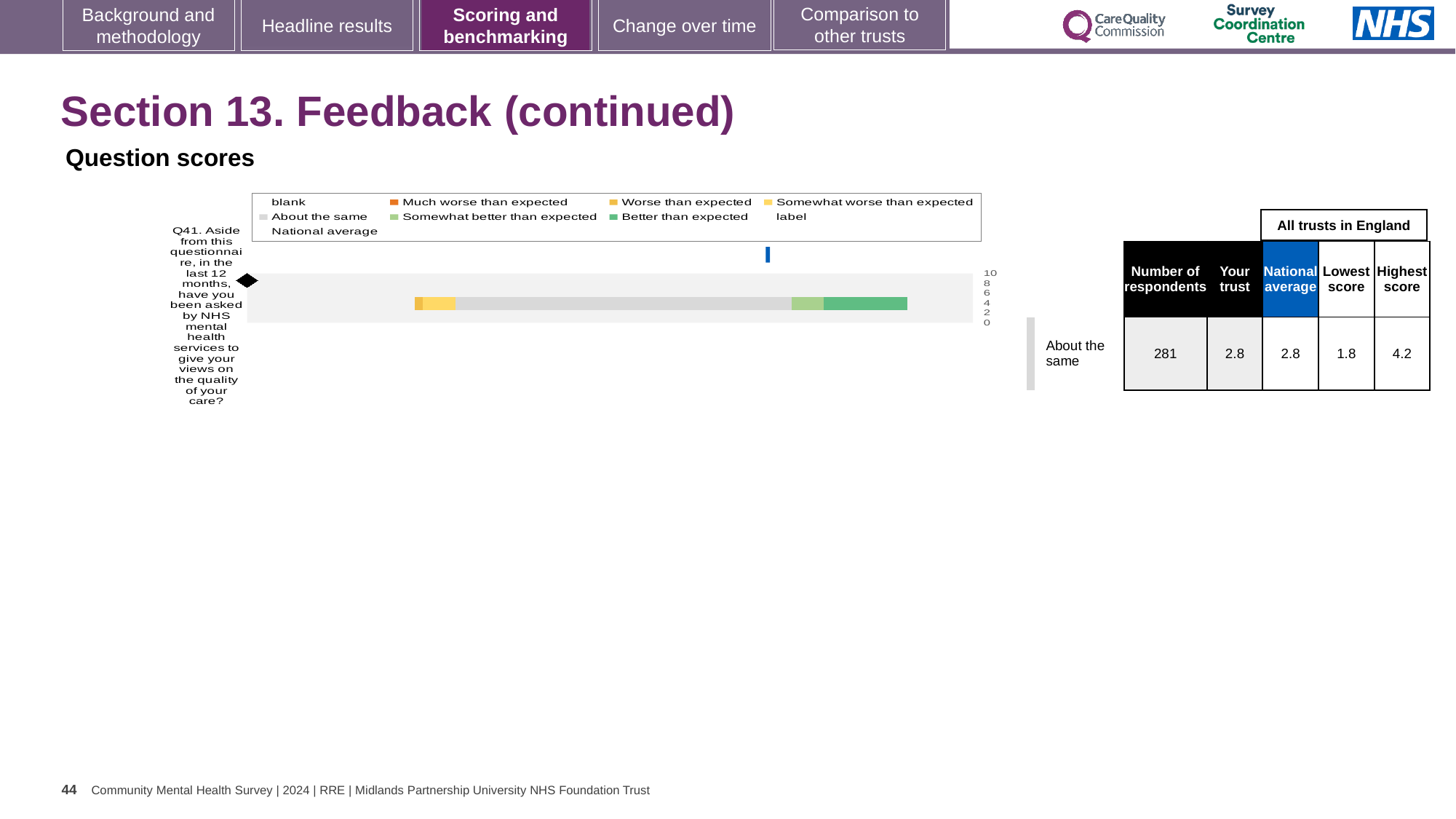
What is the national average score shown for Q41? 2.8 How many entries does the chart legend list? 9 What benchmark category is the trust's Q41 score placed in? About the same Which question number is plotted in the chart? Q41 Which legend entry is shown in dark green? Better than expected What is the highest score among all trusts in England for Q41? 4.2 What is the difference between the highest score and the lowest score for Q41? 2.4 What is the 'Your trust' score shown for Q41? 2.8 What is the lowest score among all trusts in England for Q41? 1.8 How many questions (categories) are plotted in the chart? 1 What is the number of respondents shown for Q41? 281 What kind of chart is shown on the slide? bar chart